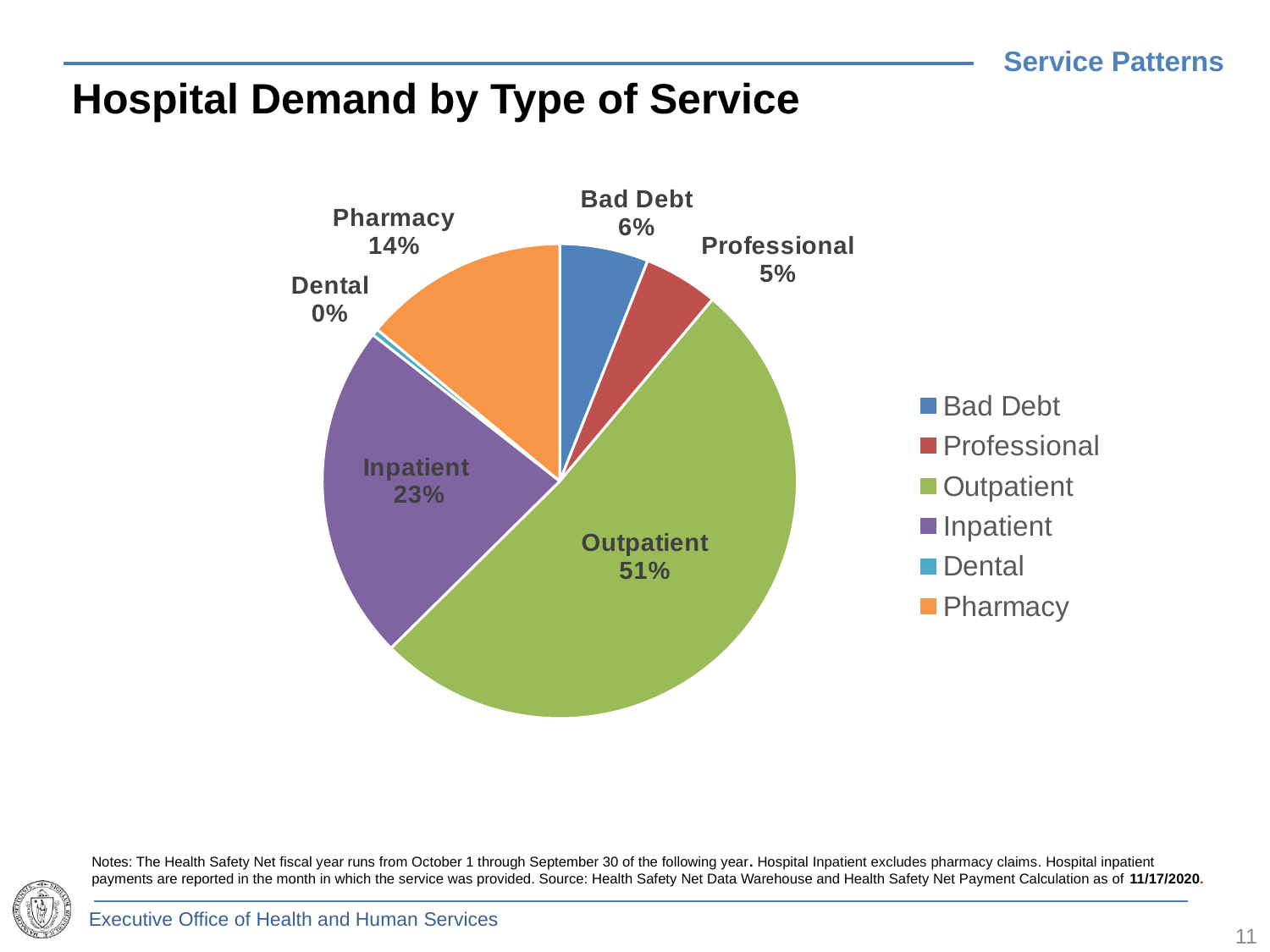
What type of chart is shown on the slide? pie chart Which type of service has the smallest share of hospital demand? Dental What share of hospital demand is Dental? 0% Which type of service has the largest share of hospital demand? Outpatient What is the difference in percentage points between the Outpatient and Inpatient shares? 28 What share of hospital demand is Pharmacy? 14% What share of hospital demand is Outpatient? 51% Which has a larger share, Bad Debt or Professional? Bad Debt What share of hospital demand is Inpatient? 23% How many types of service are shown in the pie chart? 6 What share of hospital demand is Bad Debt? 6% What is the title of the chart? Hospital Demand by Type of Service